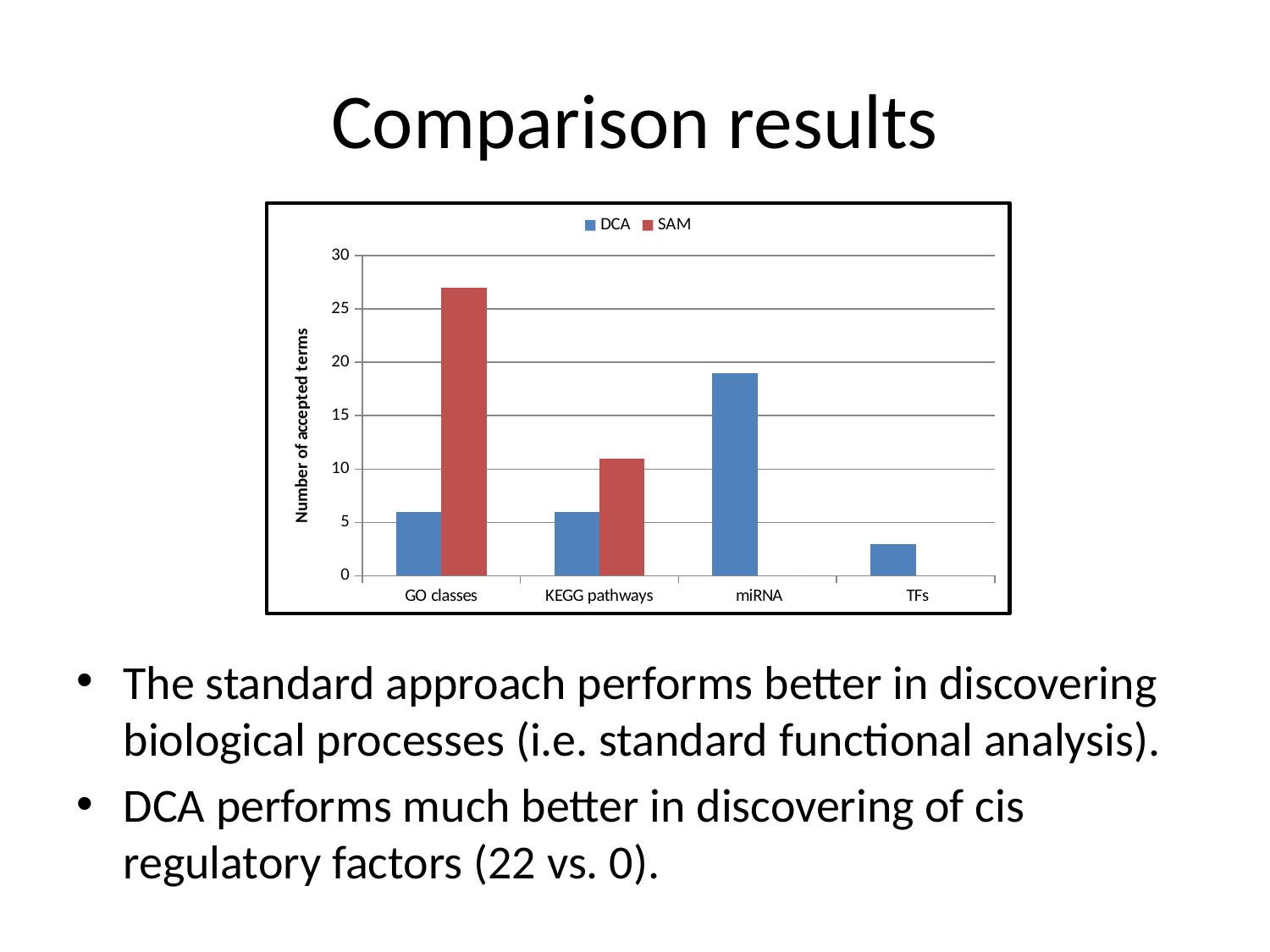
How many series does the legend list? 2 Is the DCA value for miRNA greater or less than 15? greater For miRNA, which series has the larger value, DCA or SAM? DCA Is the SAM value for GO classes greater or less than 25? greater How many categories are shown on the x axis? 4 Is the DCA value for TFs greater or less than 5? less What kind of chart is shown on the slide? bar chart For GO classes, which series has the larger value, DCA or SAM? SAM Which category has the tallest bar in the chart? GO classes For the DCA series, which category has the highest value? miRNA What is the label of the vertical axis? Number of accepted terms For the DCA series, which category has the lowest value? TFs